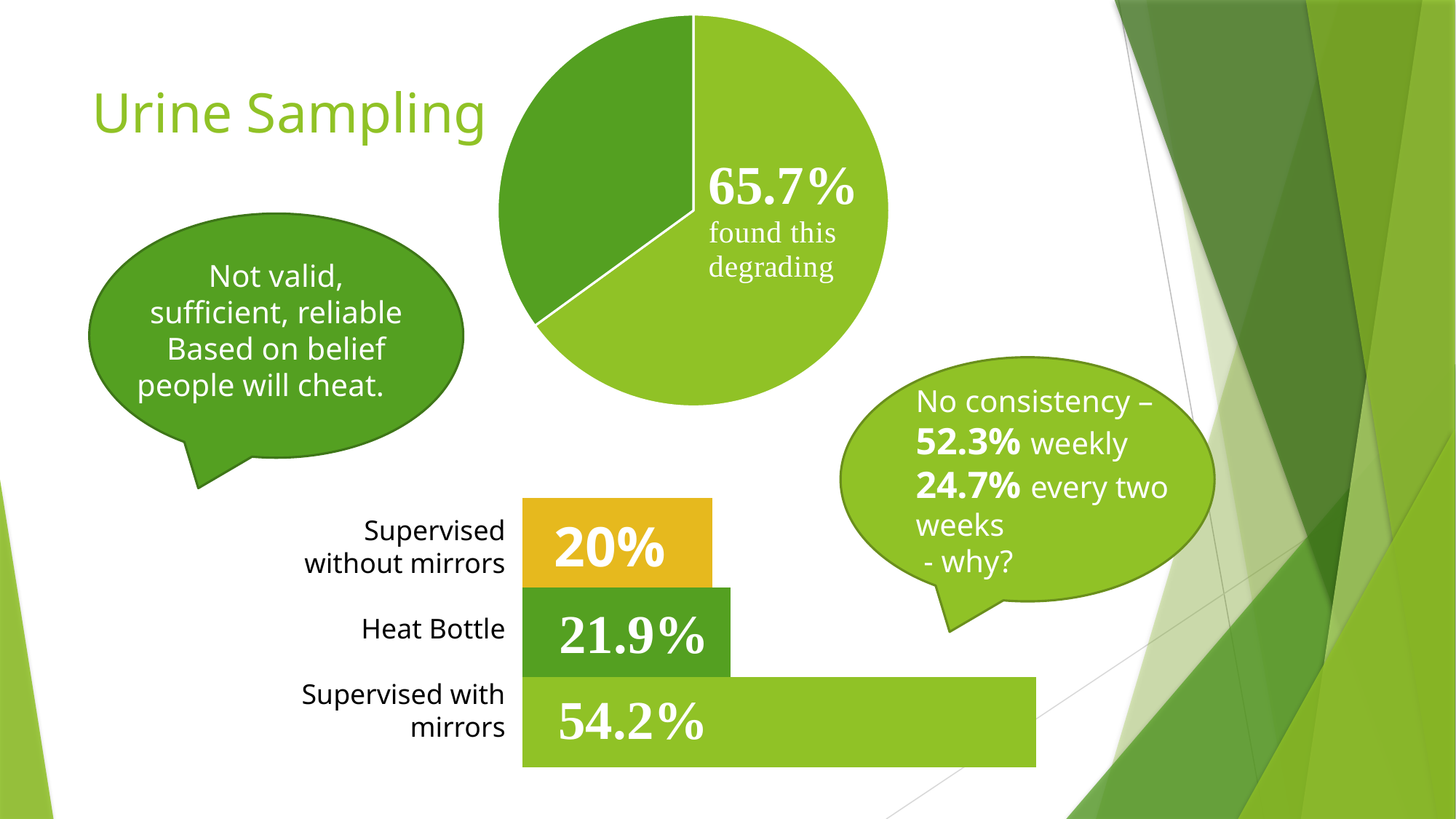
On the bar chart at the bottom of the slide, what is the value for Supervised with mirrors? 54.2% What kind of chart is shown at the bottom of the slide? Bar chart On the pie chart at the top of the slide, what share is labelled as having found this degrading? 65.7% How many categories does the bar chart at the bottom of the slide show? 3 On the bar chart at the bottom of the slide, which is larger: Heat Bottle or Supervised without mirrors? Heat Bottle On the bar chart at the bottom of the slide, what is the value for Heat Bottle? 21.9% On the bar chart at the bottom of the slide, what is the value for Supervised without mirrors? 20% On the bar chart at the bottom of the slide, which category has the lowest value? Supervised without mirrors On the bar chart at the bottom of the slide, what is the difference between Supervised with mirrors and Heat Bottle? 32.3% On the bar chart at the bottom of the slide, which category has the highest value? Supervised with mirrors On the bar chart at the bottom of the slide, what colour is the bar for Supervised without mirrors? Yellow What kind of chart is shown at the top of the slide? Pie chart